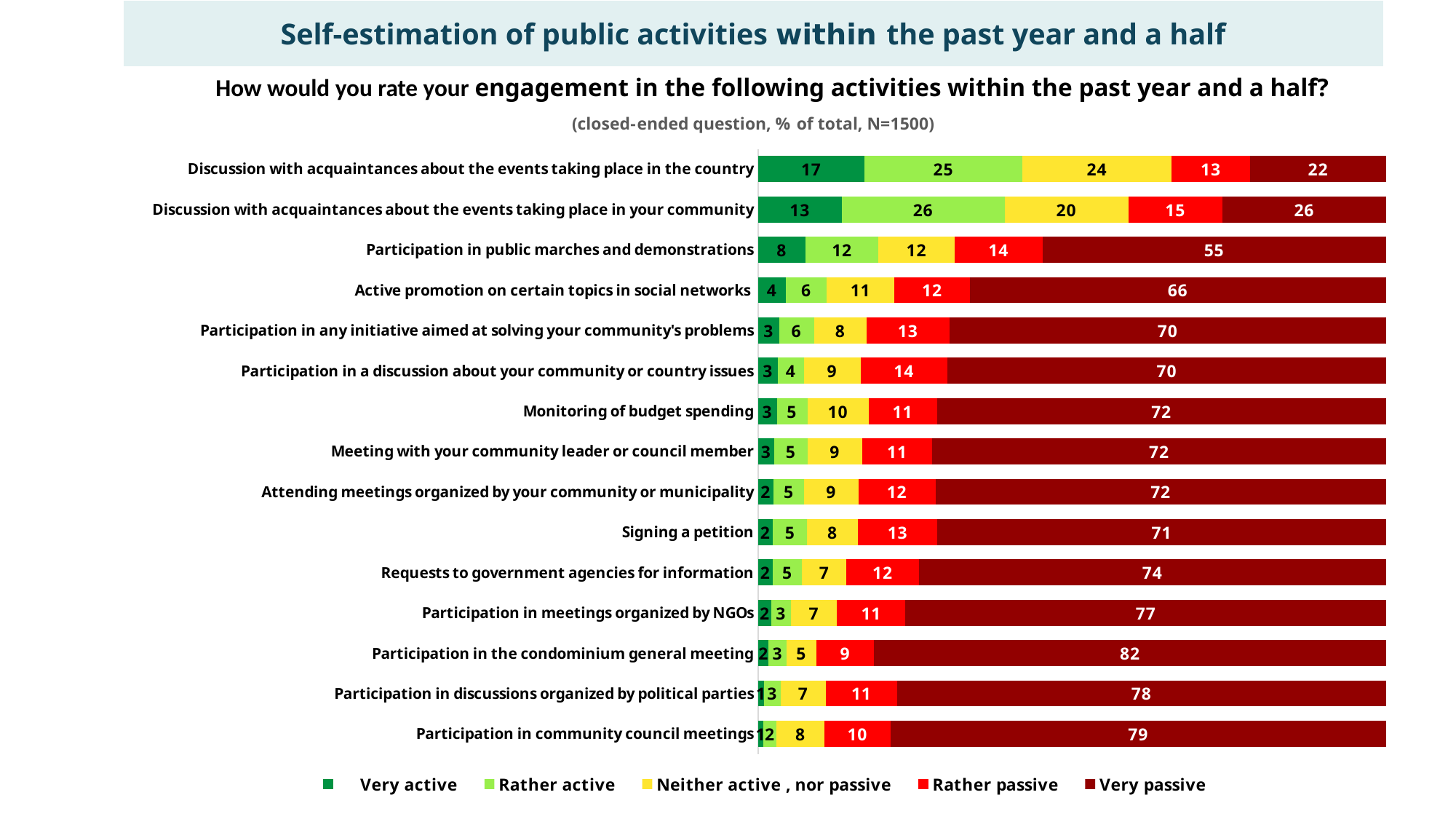
What is the "Neither active, nor passive" value for active promotion on certain topics in social networks? 11 What is the "Very passive" value for participation in public marches and demonstrations? 55 Which activity has the highest "Very passive" value? Participation in the condominium general meeting Which is larger: the "Rather passive" value for discussion with acquaintances about the events taking place in your community or for participation in public marches and demonstrations? Discussion with acquaintances about the events taking place in your community What is the difference between the "Very passive" values for participation in the condominium general meeting and participation in public marches and demonstrations? 27 How many series does the legend list? 5 What kind of chart is shown on the slide? Stacked bar chart Which colour represents the "Very passive" series in the legend? Dark red What percentage of respondents were "Very active" in discussion with acquaintances about the events taking place in the country? 17 What is the "Rather active" value for discussion with acquaintances about the events taking place in your community? 26 Which activity has the lowest "Very passive" value? Discussion with acquaintances about the events taking place in the country How many activities are listed in the chart? 15